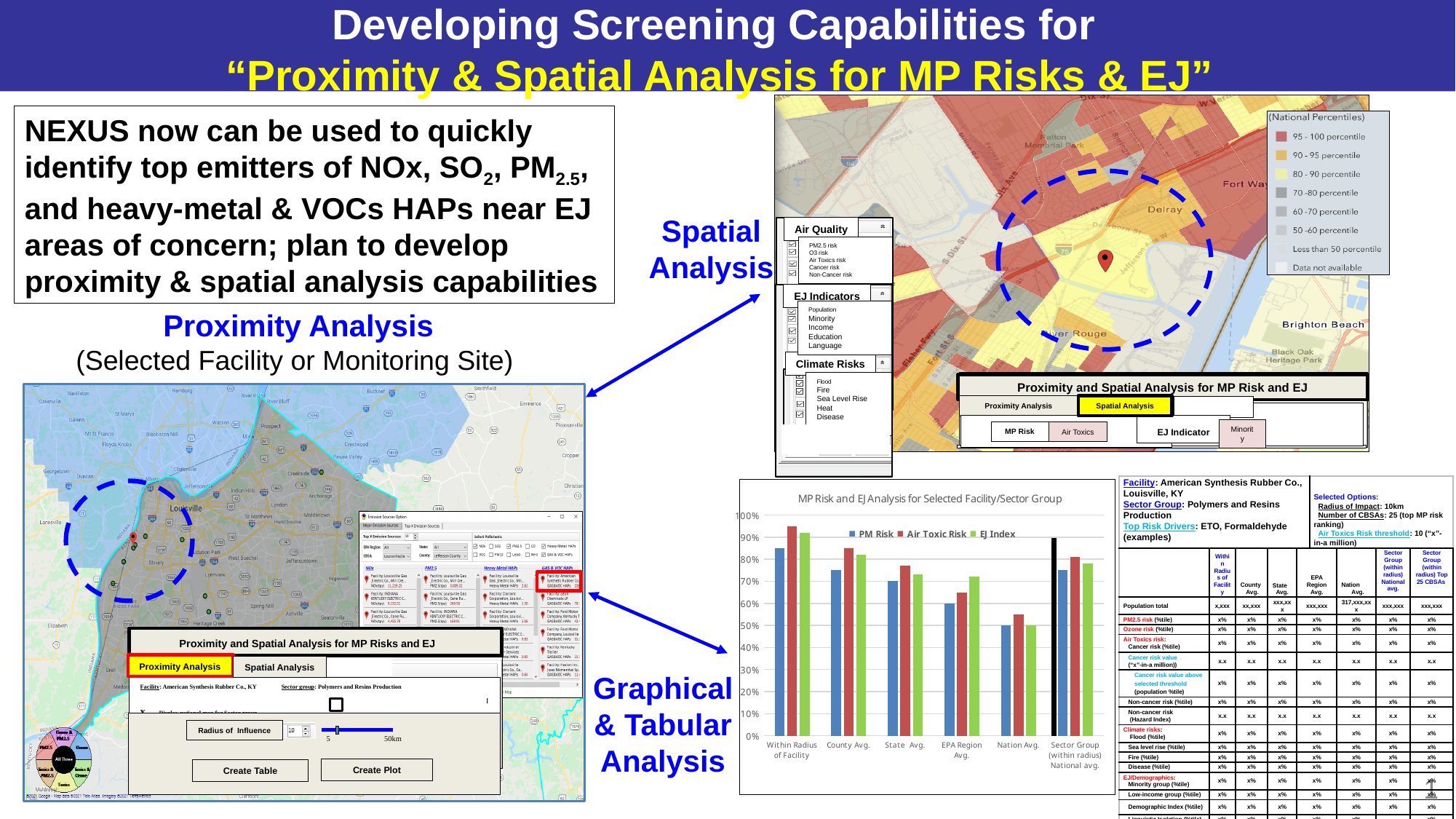
How many series does the legend of the "MP Risk and EJ Analysis for Selected Facility/Sector Group" chart list? 3 In the "MP Risk and EJ Analysis for Selected Facility/Sector Group" chart, which category has the highest Air Toxic Risk? Within Radius of Facility What type of chart is "MP Risk and EJ Analysis for Selected Facility/Sector Group"? bar chart In the "MP Risk and EJ Analysis for Selected Facility/Sector Group" chart, is the Air Toxic Risk value for County Avg. greater or less than 80%? greater In the "MP Risk and EJ Analysis for Selected Facility/Sector Group" chart, which is larger for EPA Region Avg.: the PM Risk or the EJ Index? EJ Index In the "MP Risk and EJ Analysis for Selected Facility/Sector Group" chart, does the PM Risk rise or fall from Within Radius of Facility to Nation Avg.? fall Which series are listed in the legend of the "MP Risk and EJ Analysis for Selected Facility/Sector Group" chart? PM Risk, Air Toxic Risk, EJ Index In the "MP Risk and EJ Analysis for Selected Facility/Sector Group" chart, is the PM Risk value for Nation Avg. greater or less than 60%? less In the "MP Risk and EJ Analysis for Selected Facility/Sector Group" chart, is the Air Toxic Risk value for Within Radius of Facility greater or less than 90%? greater How many categories are shown on the x axis of the "MP Risk and EJ Analysis for Selected Facility/Sector Group" chart? 6 In the "MP Risk and EJ Analysis for Selected Facility/Sector Group" chart, which category has the lowest PM Risk? Nation Avg.